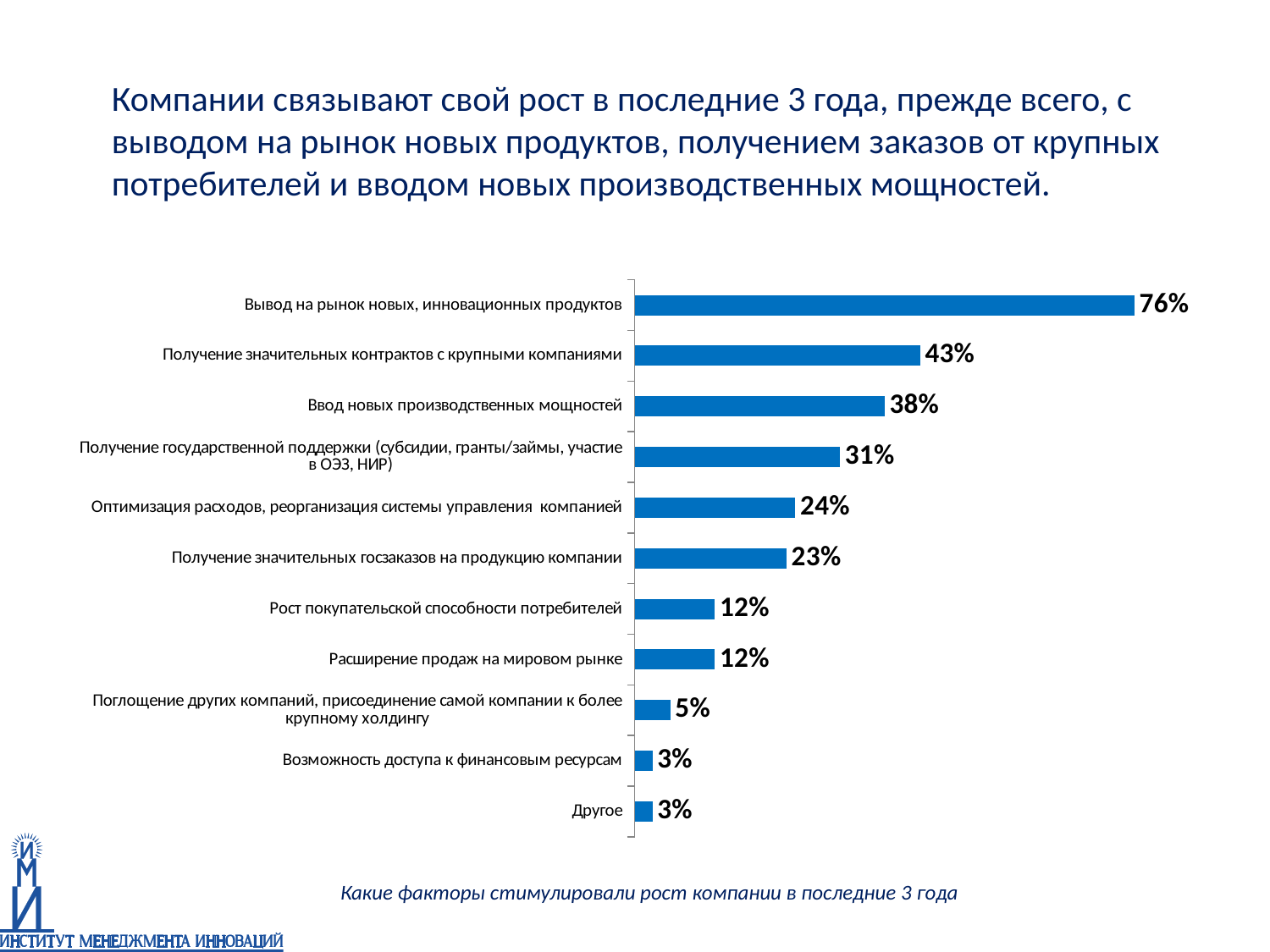
Which category has the highest value? Вывод на рынок новых, инновационных продуктов What kind of chart is shown on the slide? Bar chart What value is shown for "Получение значительных госзаказов на продукцию компании"? 23% What is the difference between the values for "Получение государственной поддержки (субсидии, гранты/займы, участие в ОЭЗ, НИР)" and "Оптимизация расходов, реорганизация системы управления компанией"? 7% What value is shown for "Вывод на рынок новых, инновационных продуктов"? 76% What value is shown for "Рост покупательской способности потребителей"? 12% How many categories are shown in the chart? 11 What value is shown for "Поглощение других компаний, присоединение самой компании к более крупному холдингу"? 5% What is the difference between the values for "Вывод на рынок новых, инновационных продуктов" and "Получение значительных контрактов с крупными компаниями"? 33% Which is larger: the value for "Ввод новых производственных мощностей" or the value for "Получение государственной поддержки (субсидии, гранты/займы, участие в ОЭЗ, НИР)"? Ввод новых производственных мощностей What question is written in italics below the chart? Какие факторы стимулировали рост компании в последние 3 года What value is shown for "Ввод новых производственных мощностей"? 38%